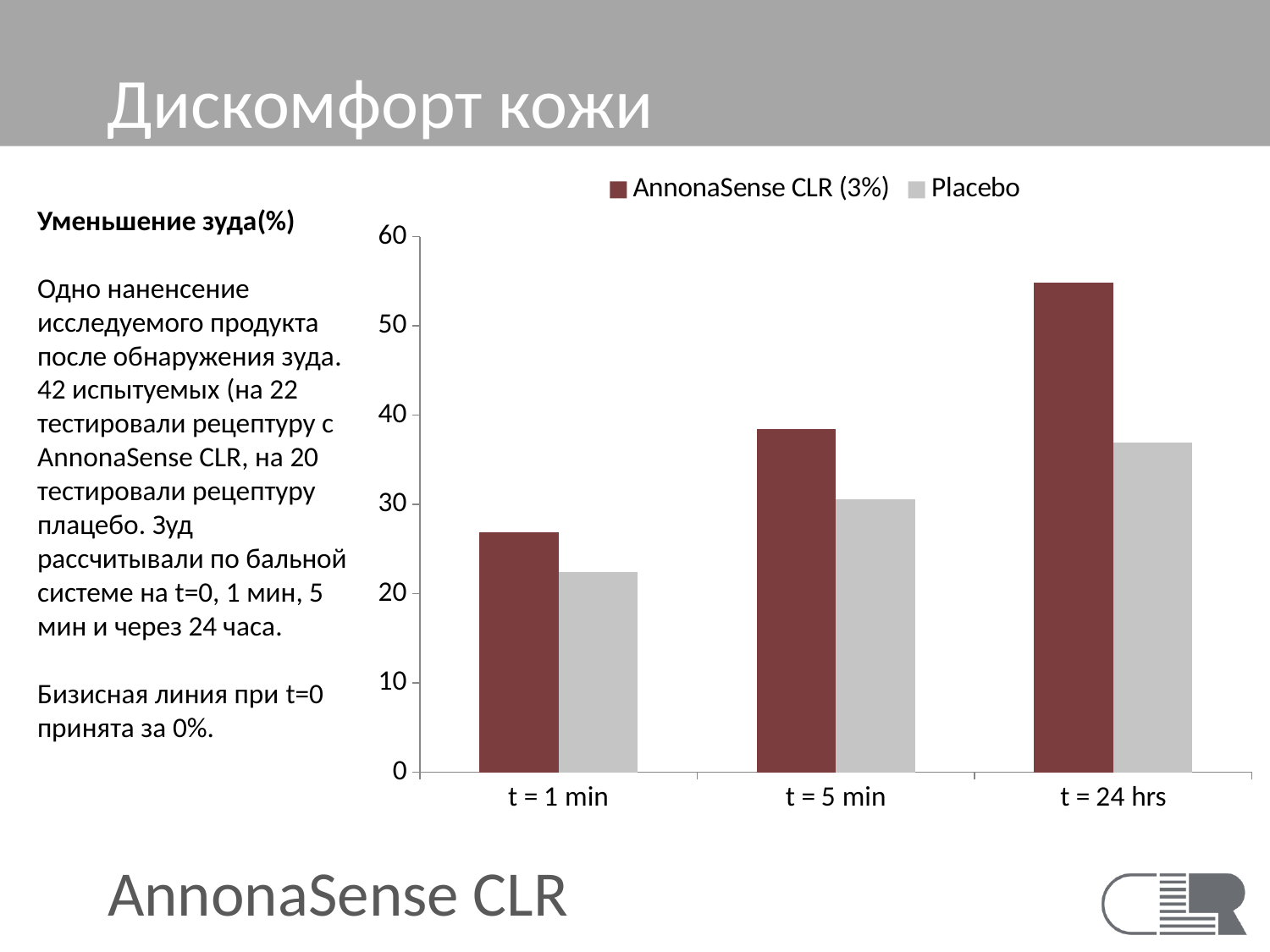
Do the Placebo values rise or fall from t = 1 min to t = 24 hrs? rise Is the AnnonaSense CLR (3%) value at t = 5 min greater or less than 30? greater What kind of chart is shown on the slide? bar chart How many series does the legend list? 2 Is the Placebo value at t = 1 min greater or less than 30? less Which series does the legend list first? AnnonaSense CLR (3%) How many time-point categories are shown on the x axis? 3 At which time point is the AnnonaSense CLR (3%) value highest? t = 24 hrs At t = 24 hrs, which is larger: AnnonaSense CLR (3%) or Placebo? AnnonaSense CLR (3%) At which time point is the Placebo value lowest? t = 1 min What colour are the Placebo bars? light grey Is the AnnonaSense CLR (3%) value at t = 24 hrs greater or less than 50? greater